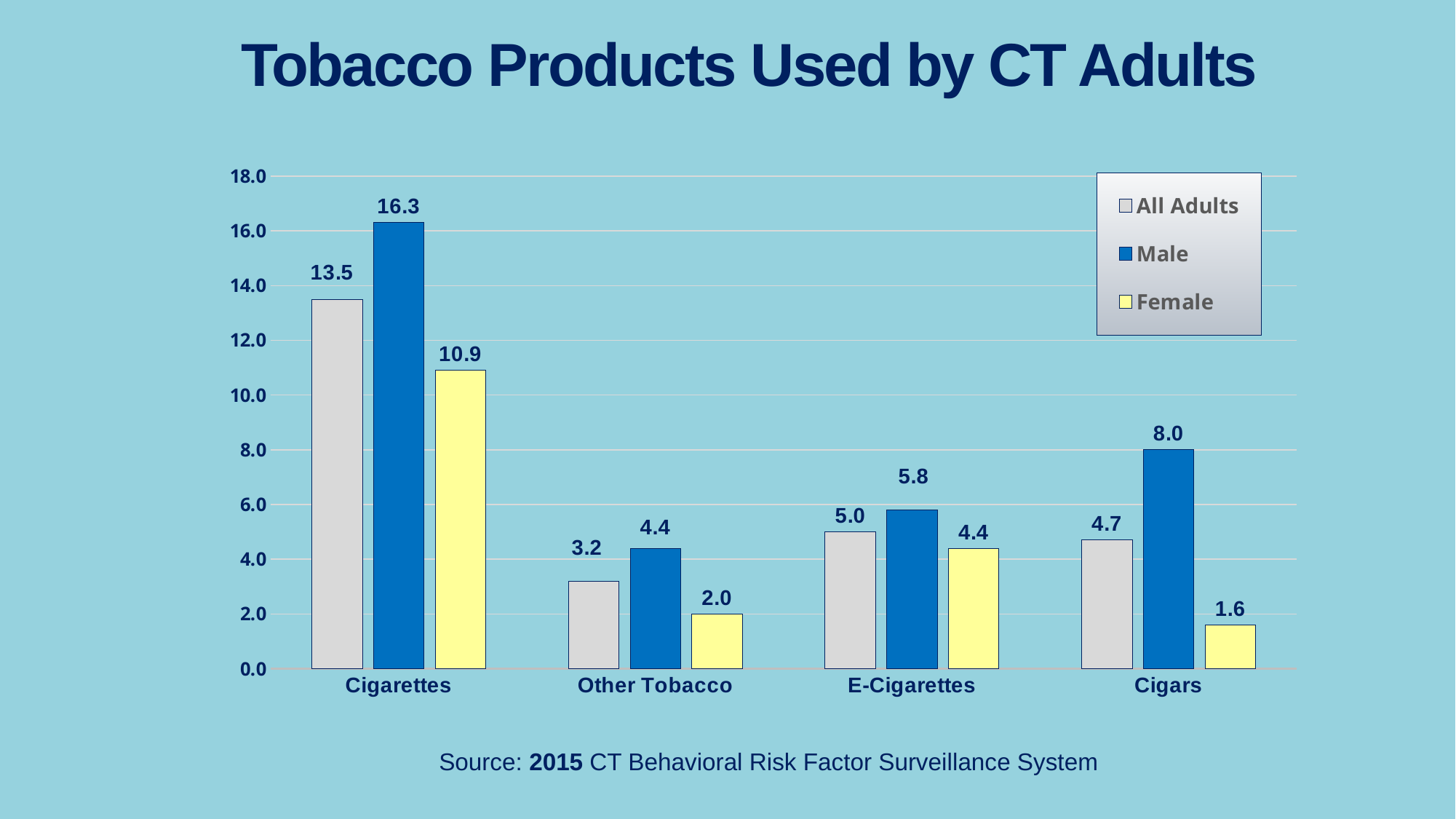
What is the value for Female in the Other Tobacco category? 2.0 How many product categories are shown on the x axis? 4 Is the Female value for Cigarettes greater or less than 10.0? greater What is the title of the chart? Tobacco Products Used by CT Adults Which category has the lowest Female value? Cigars What is the value for Male in the Cigarettes category? 16.3 What kind of chart is shown on the slide? Bar chart Which category has the highest Male value? Cigarettes How many series does the legend list? 3 What is the difference between the Male and Female values for Cigars? 6.4 What is the value for All Adults in the E-Cigarettes category? 5.0 Which is larger: the All Adults value for E-Cigarettes or the All Adults value for Cigars? E-Cigarettes